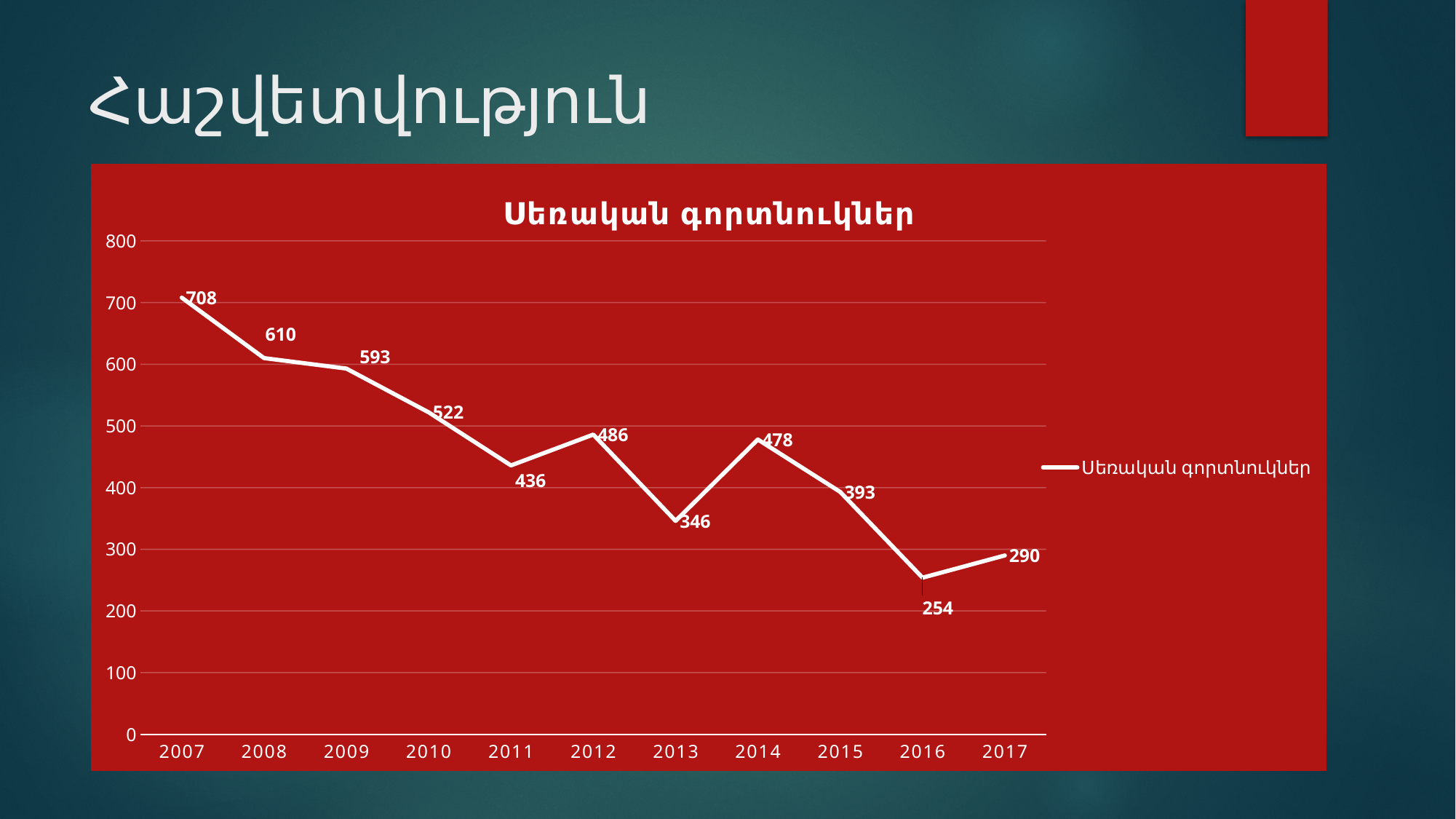
What is the difference between the values for 2012 and 2013? 140 How many series does the legend list? 1 Do the values generally rise or fall from 2007 to 2017? fall What is the value for 2013? 346 What is the difference between the values for 2007 and 2017? 418 What is the value for 2007? 708 Which is larger, the value for 2012 or the value for 2014? 2012 What kind of chart is shown on the slide? line chart What is the value for 2017? 290 Which year has the lowest value? 2016 How many years are plotted on the x axis? 11 Which year has the highest value? 2007